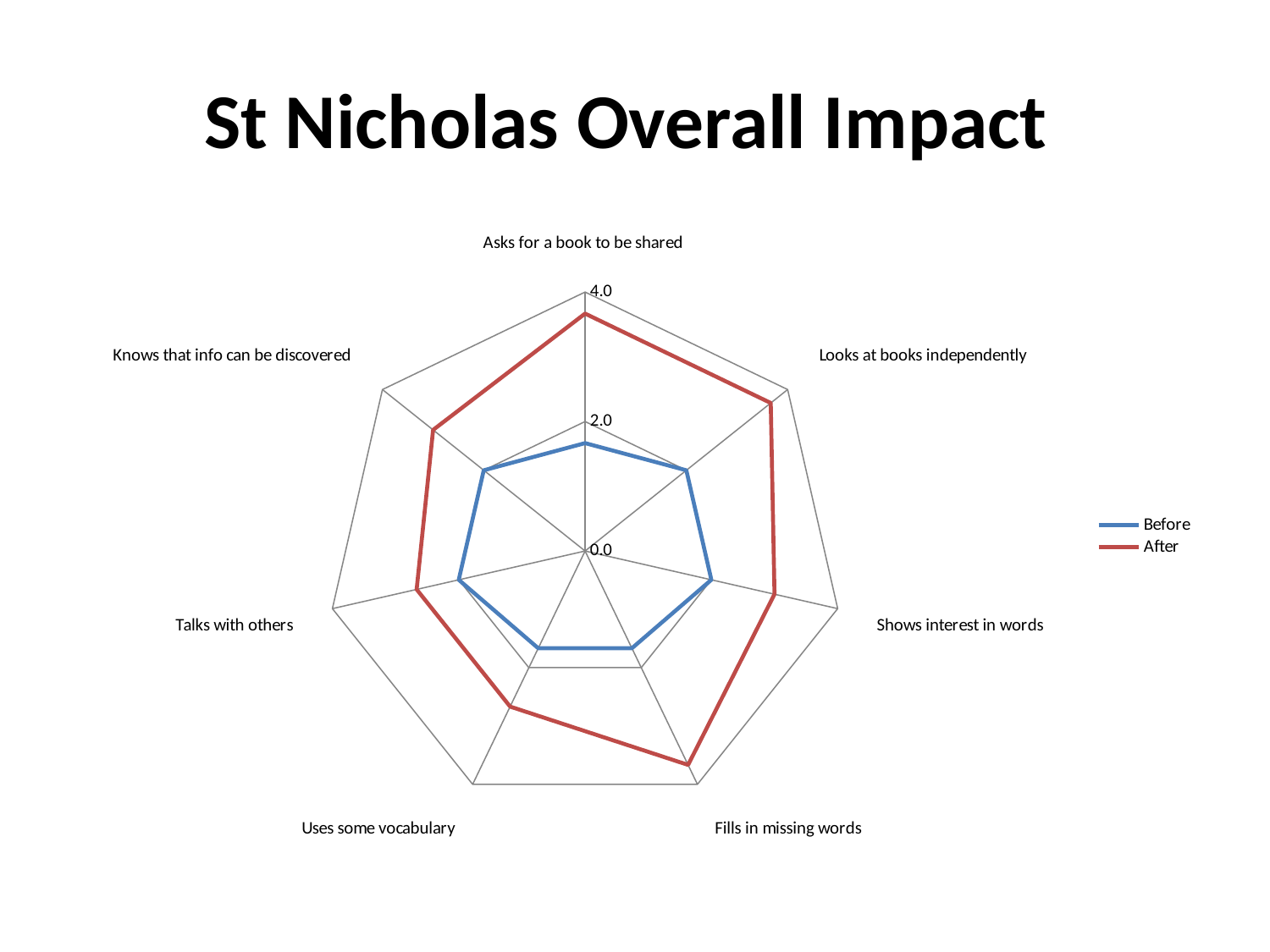
Which colour represents the After series in the chart? Red Is the After value for Shows interest in words greater or less than 2.0? greater Is the After value for Asks for a book to be shared greater or less than 2.0? greater What kind of chart is shown on the slide? Radar chart Is the Before value for Asks for a book to be shared greater or less than 2.0? less For Knows that info can be discovered, which series has the larger value, Before or After? After How many series does the legend list? 2 What is the title of the slide containing the chart? St Nicholas Overall Impact How many categories (axes) does the radar chart have? 7 For Fills in missing words, which series has the larger value, Before or After? After